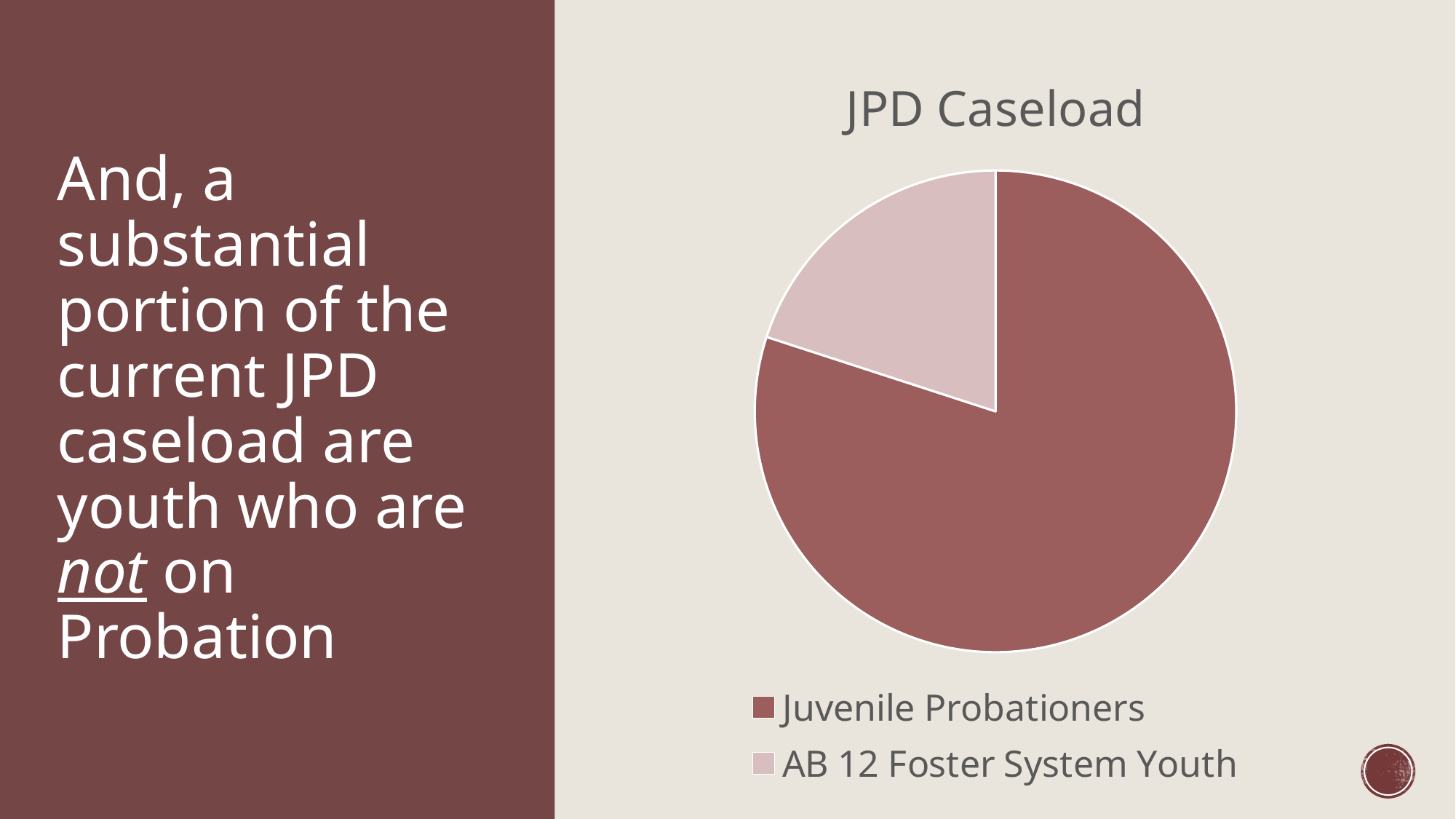
How many entries does the legend list? 2 What is the title of the chart? JPD Caseload Which category has the largest slice of the pie? Juvenile Probationers Which category has the smallest slice of the pie? AB 12 Foster System Youth Which slice is larger, Juvenile Probationers or AB 12 Foster System Youth? Juvenile Probationers Which legend entry is shown in the lighter pink colour? AB 12 Foster System Youth What kind of chart is shown on the slide? pie chart How many slices does the pie chart have? 2